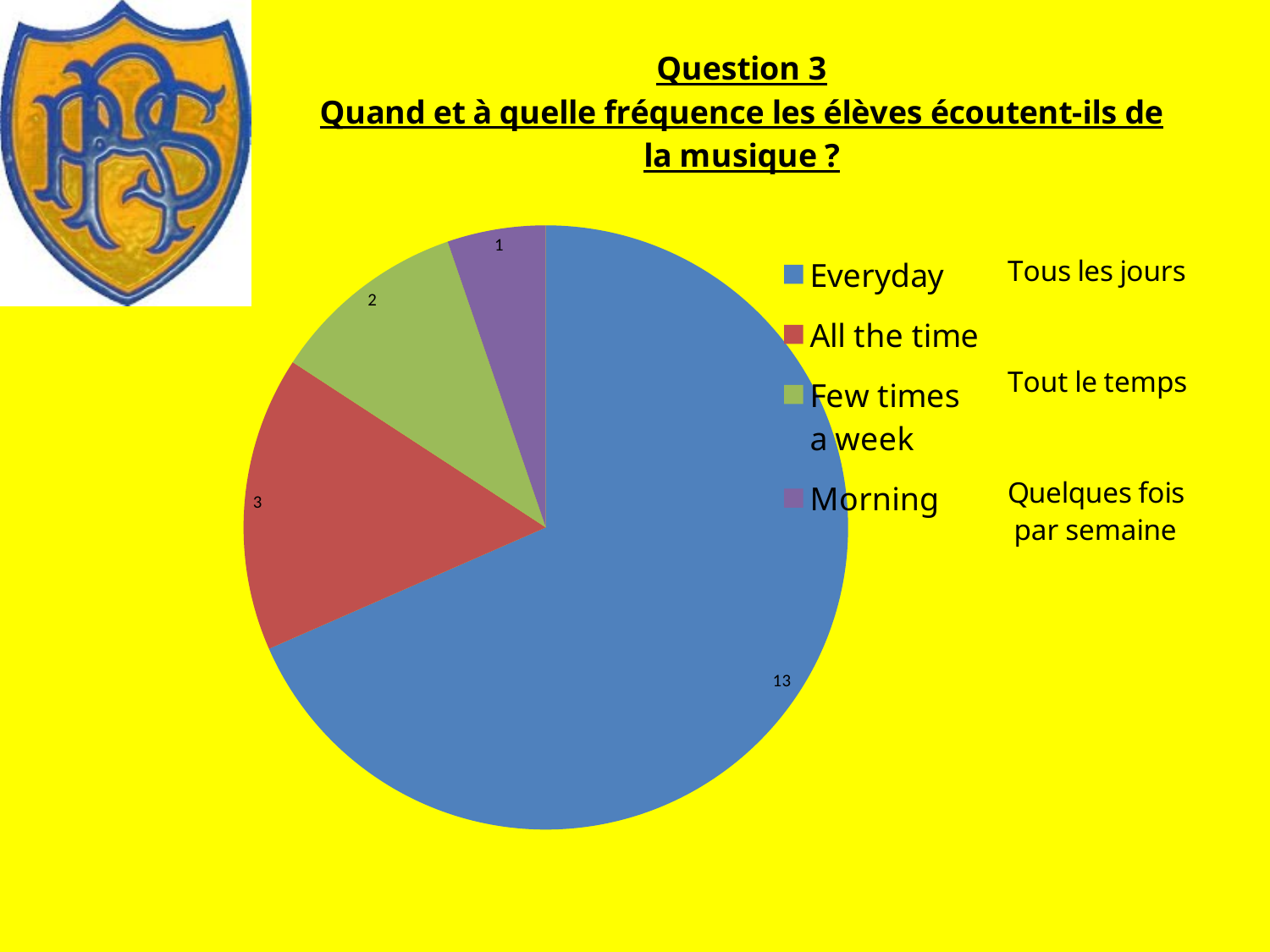
Which category has the largest slice of the pie? Everyday What is the total of all the values in the pie chart? 19 What is the value for 'All the time'? 3 Which is larger, the value for 'All the time' or the value for 'Few times a week'? All the time How many categories does the pie chart have? 4 What is the difference between the values for 'Everyday' and 'All the time'? 10 What colour is the 'Everyday' slice? blue What type of chart is shown on the slide? pie chart How many students answered 'Everyday'? 13 What is the value for 'Few times a week'? 2 Which category has the smallest slice of the pie? Morning What is the value for 'Morning'? 1